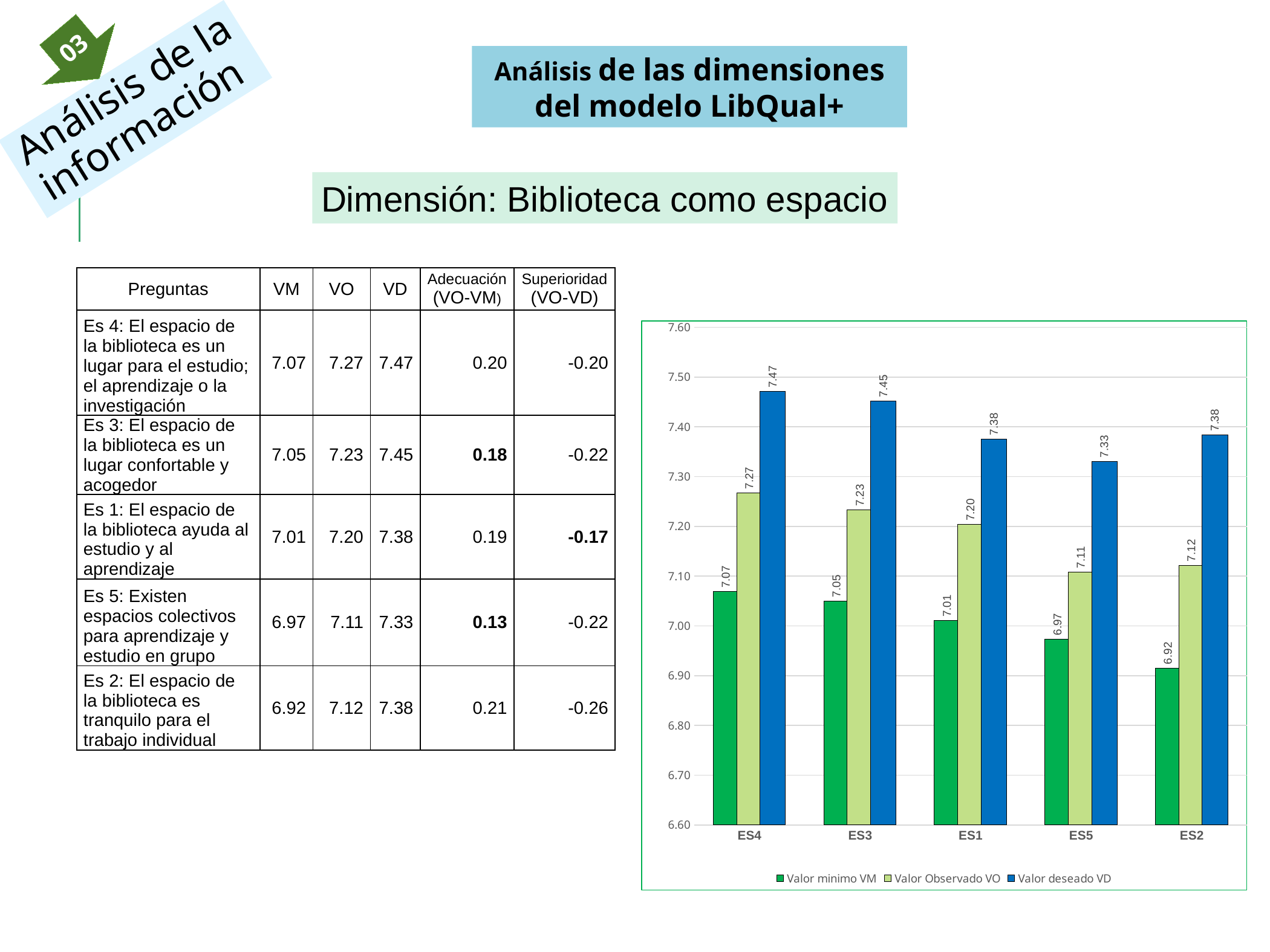
Which category has the lowest Valor minimo VM value? ES2 What is the Valor deseado VD value for ES4? 7.47 Do the Valor minimo VM values rise or fall from ES4 to ES2 along the x axis? fall What kind of chart is shown on the slide? bar chart Is the Valor deseado VD value for ES5 greater or less than 7.30? greater What is the Valor minimo VM value for ES2? 6.92 What is the Valor Observado VO value for ES5? 7.11 What is the difference between the Valor deseado VD and Valor minimo VM values for ES1? 0.37 Which is larger, the Valor Observado VO value for ES3 or for ES2? ES3 How many series does the chart legend list? 3 How many categories are shown on the x axis of the chart? 5 Which category has the highest Valor deseado VD value? ES4